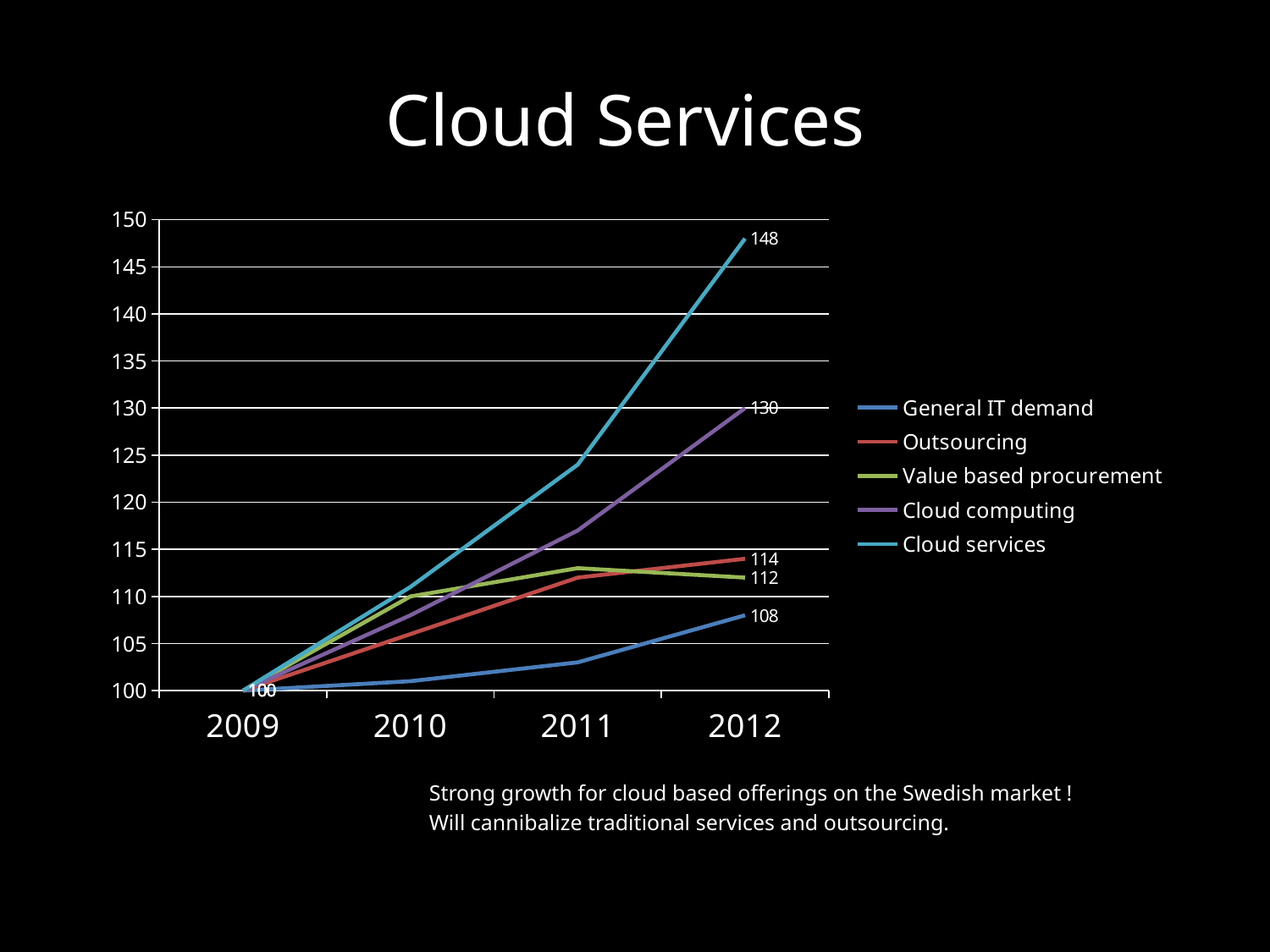
What is the difference between the 2012 values for Cloud services and Cloud computing? 18 What is the value for General IT demand in 2012? 108 What is the value for Cloud services in 2012? 148 How many years are shown on the x axis? 4 Which series has the lowest value in 2012? General IT demand Does the Cloud services line rise or fall from 2009 to 2012? rise Is the value for Cloud services in 2011 greater or less than 120? greater Which series has the highest value in 2012? Cloud services What kind of chart is shown on the slide? line chart In 2012, which is larger: Outsourcing or Value based procurement? Outsourcing What is the value for Cloud computing in 2012? 130 How many series does the legend list? 5